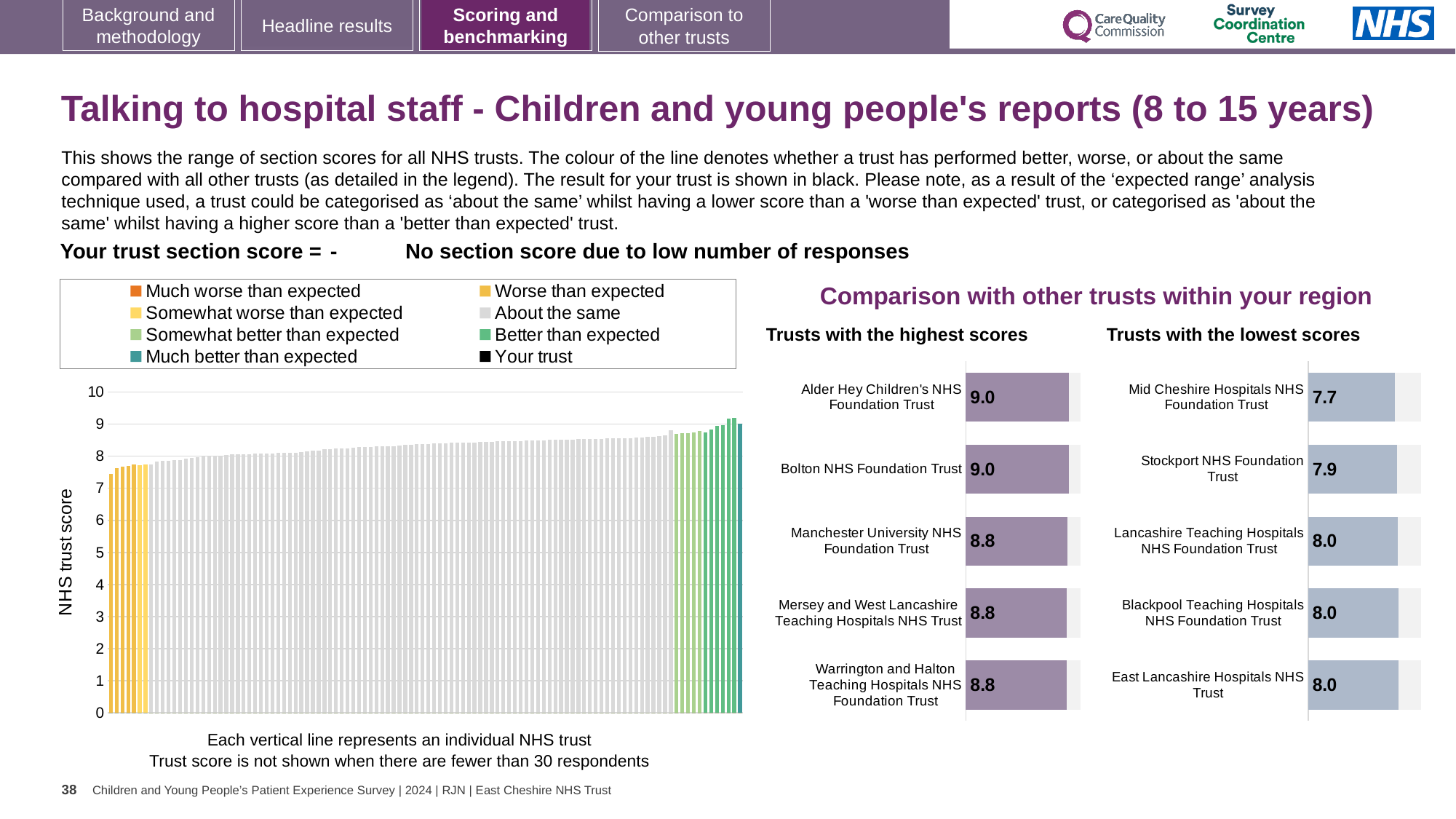
In the 'Trusts with the highest scores' chart, which is larger: the score for Bolton NHS Foundation Trust or the score for Warrington and Halton Teaching Hospitals NHS Foundation Trust? Bolton NHS Foundation Trust How many trusts are shown in the 'Trusts with the highest scores' chart? 5 In the 'Trusts with the lowest scores' chart, what is the difference between the scores for Stockport NHS Foundation Trust and Mid Cheshire Hospitals NHS Foundation Trust? 0.2 In the 'Trusts with the lowest scores' chart, what is the score for Mid Cheshire Hospitals NHS Foundation Trust? 7.7 In the 'Trusts with the lowest scores' chart, which trust has the lowest score? Mid Cheshire Hospitals NHS Foundation Trust What kind of chart is the main chart on the left with the 'NHS trust score' axis? Bar chart In the 'Trusts with the lowest scores' chart, what is the score for Stockport NHS Foundation Trust? 7.9 In the 'Trusts with the highest scores' chart, what is the score for Manchester University NHS Foundation Trust? 8.8 In the main 'NHS trust score' chart, do the bar values rise or fall from left to right? Rise In the main 'NHS trust score' chart, is the value of the leftmost bar greater or less than 8? less In the 'Trusts with the highest scores' chart, what is the score for Alder Hey Children's NHS Foundation Trust? 9.0 How many entries does the legend of the main 'NHS trust score' chart list? 8